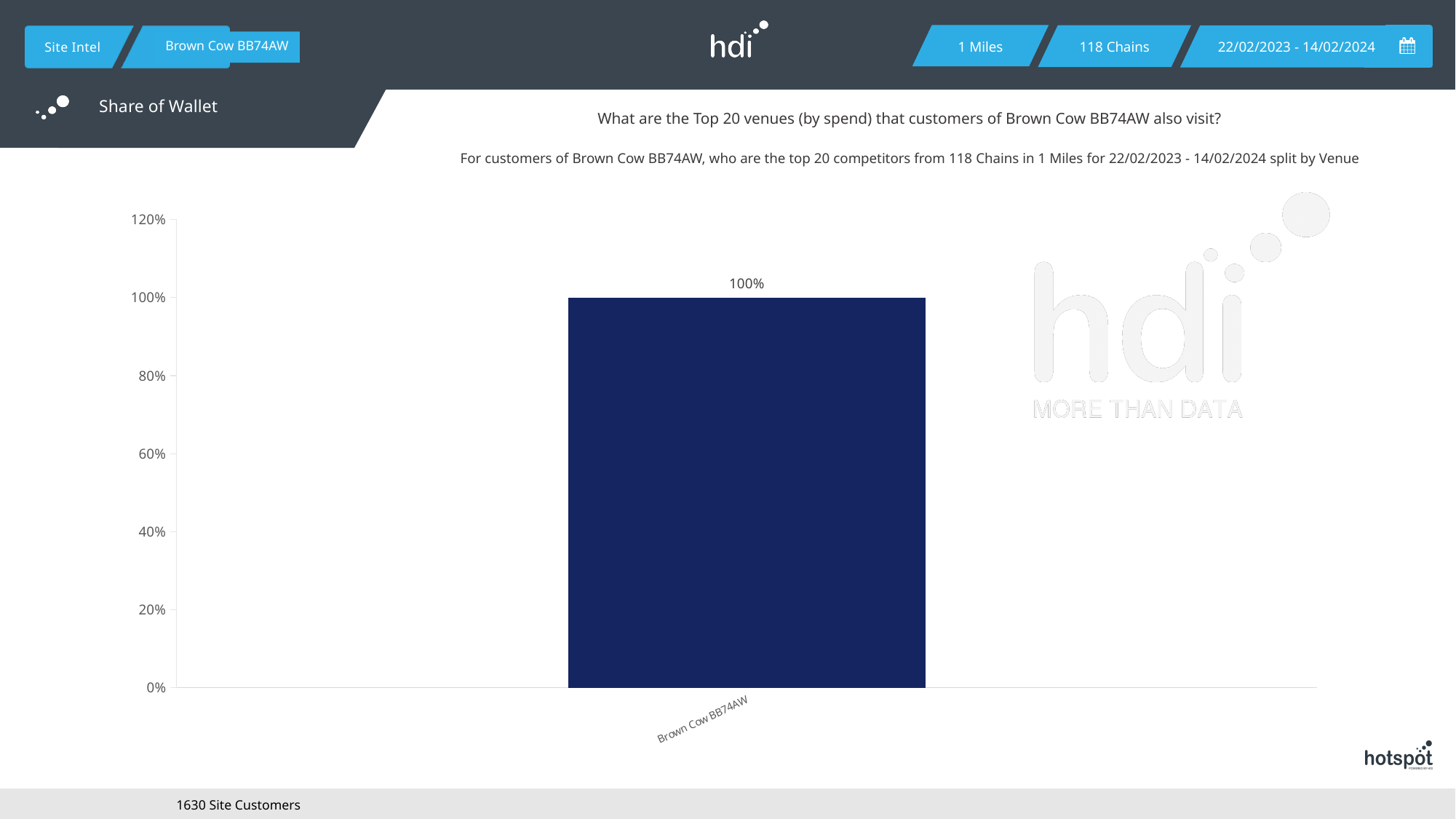
Which category has the highest value in the chart? Brown Cow BB74AW What kind of chart is shown on the slide? bar chart Is the value for Brown Cow BB74AW greater or less than 120%? less What is the value for Brown Cow BB74AW in the chart? 100% How many bars are plotted in the chart? 1 What is the highest value shown on the y axis of the chart? 120% Is the value for Brown Cow BB74AW greater or less than 80%? greater What is the label of the only category on the x axis? Brown Cow BB74AW